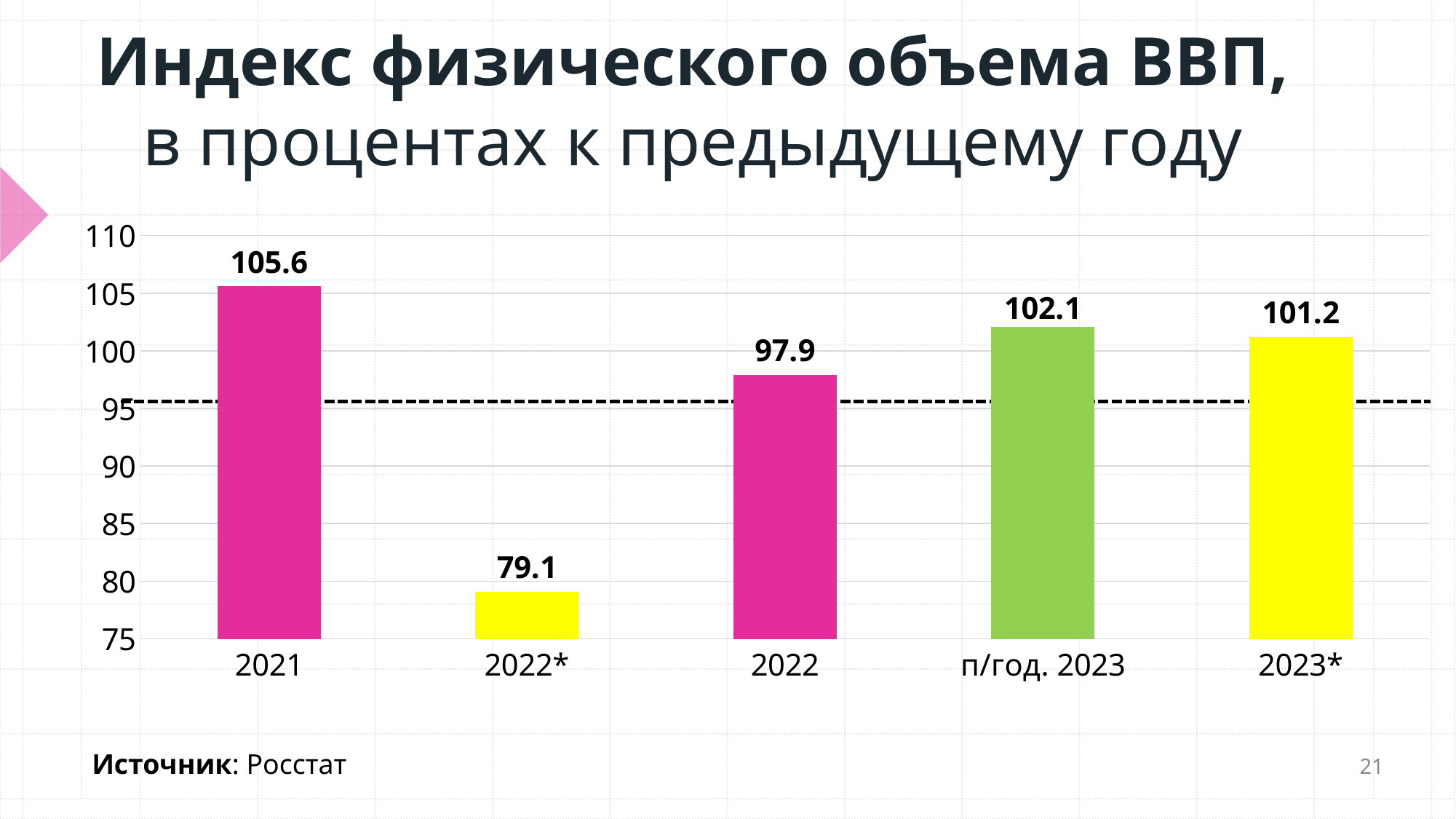
What is the value for 2021? 105.6 Which category has the lowest value? 2022* What is the value for 2022*? 79.1 Which is larger, the value for 2022 or the value for п/год. 2023? п/год. 2023 What is the value for 2023*? 101.2 What source is cited for the chart data? Росстат Is the value for 2022 greater or less than 100? less What kind of chart is shown on the slide? bar chart What is the value for п/год. 2023? 102.1 What is the difference between the values for 2021 and 2022? 7.7 How many bars are shown in the chart? 5 Which category has the highest value? 2021